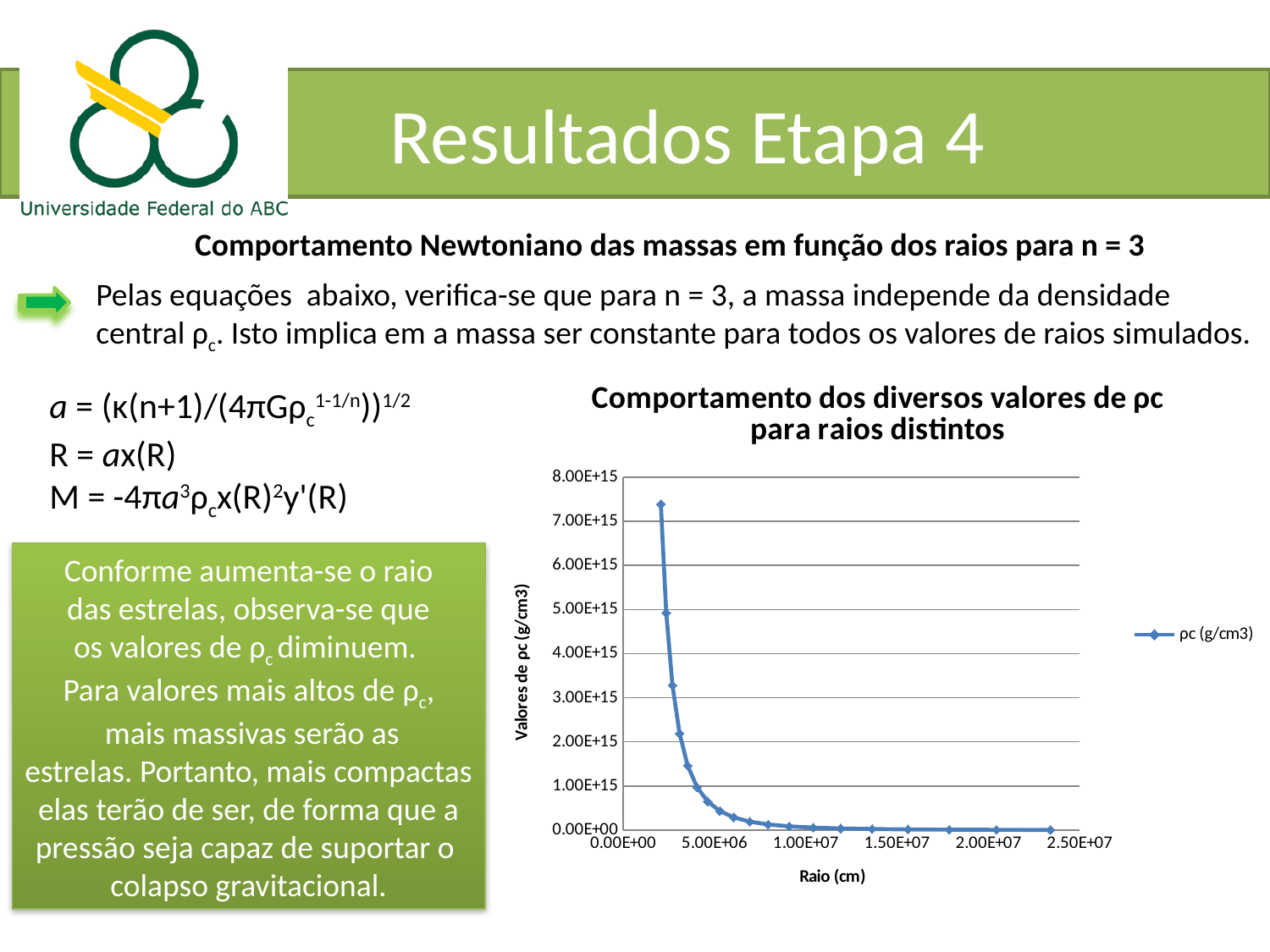
Is the value of ρc at a radius of 1.00E+07 cm greater or less than 1.00E+15? less What kind of chart is shown on the slide? line chart Do the values of ρc rise or fall as the radius (Raio) increases along the x axis? fall What is the name of the series shown in the chart legend? ρc (g/cm3) Is the value of ρc at the smallest radius plotted greater or less than 6.00E+15? greater How many series does the chart legend list? 1 Is the value of ρc at a radius of 5.00E+06 cm greater or less than 2.00E+15? less What is the title of the chart? Comportamento dos diversos valores de ρc para raios distintos Which has the larger ρc value: the point at the smallest radius or the point at the largest radius? the point at the smallest radius